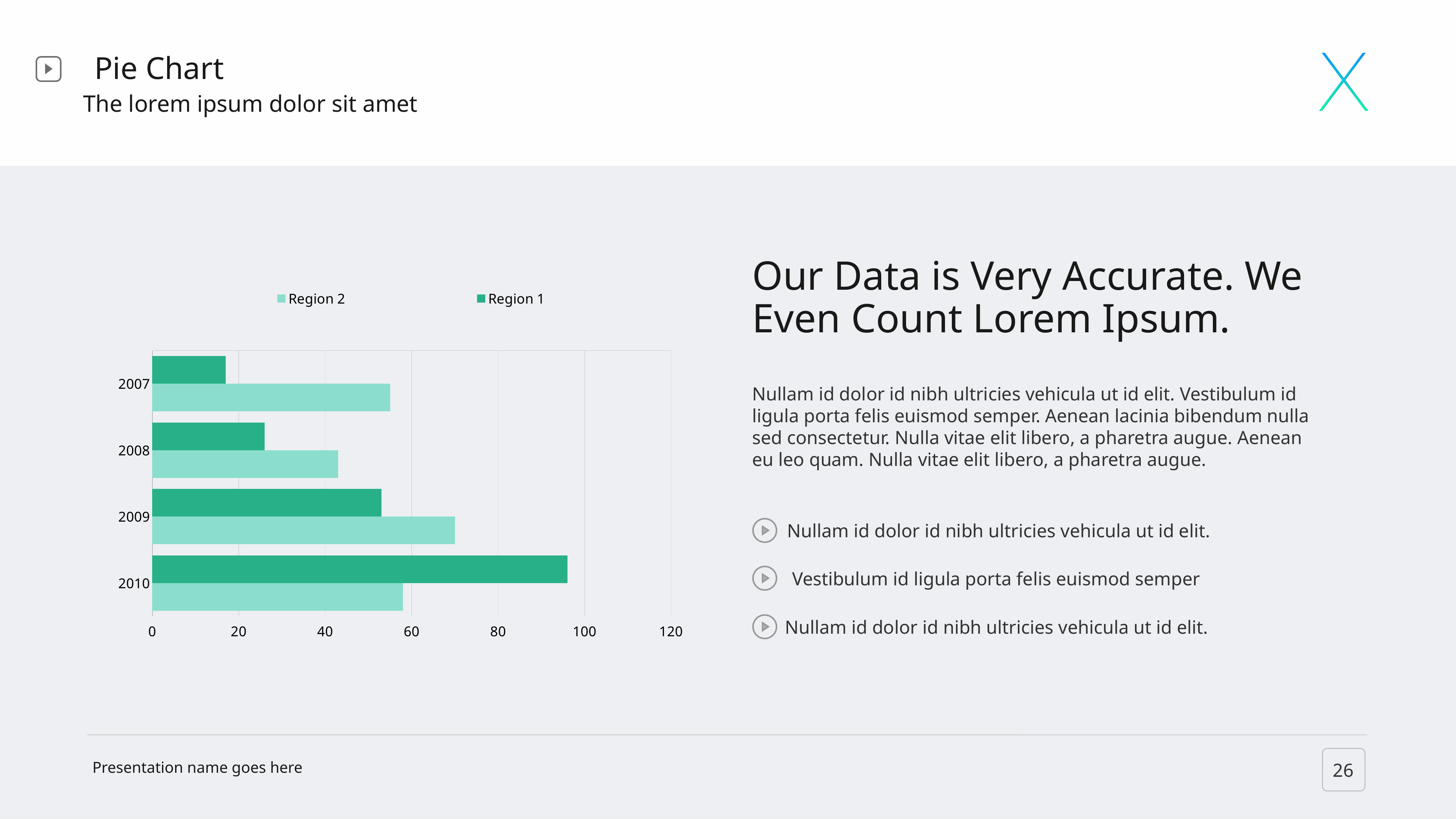
In 2007, which series has the larger value, Region 1 or Region 2? Region 2 Which year has the highest value for Region 2? 2009 How many series does the chart legend list? 2 Which year has the lowest value for Region 2? 2008 How many categories (years) are shown on the chart? 4 Is the value for Region 1 in 2010 greater or less than 80? greater What kind of chart is shown on the slide? bar chart Is the value for Region 1 in 2007 greater or less than 20? less Which year has the lowest value for Region 1? 2007 Do the Region 1 values rise or fall from 2007 to 2010? rise Which year has the highest value for Region 1? 2010 In 2010, which series has the larger value, Region 1 or Region 2? Region 1